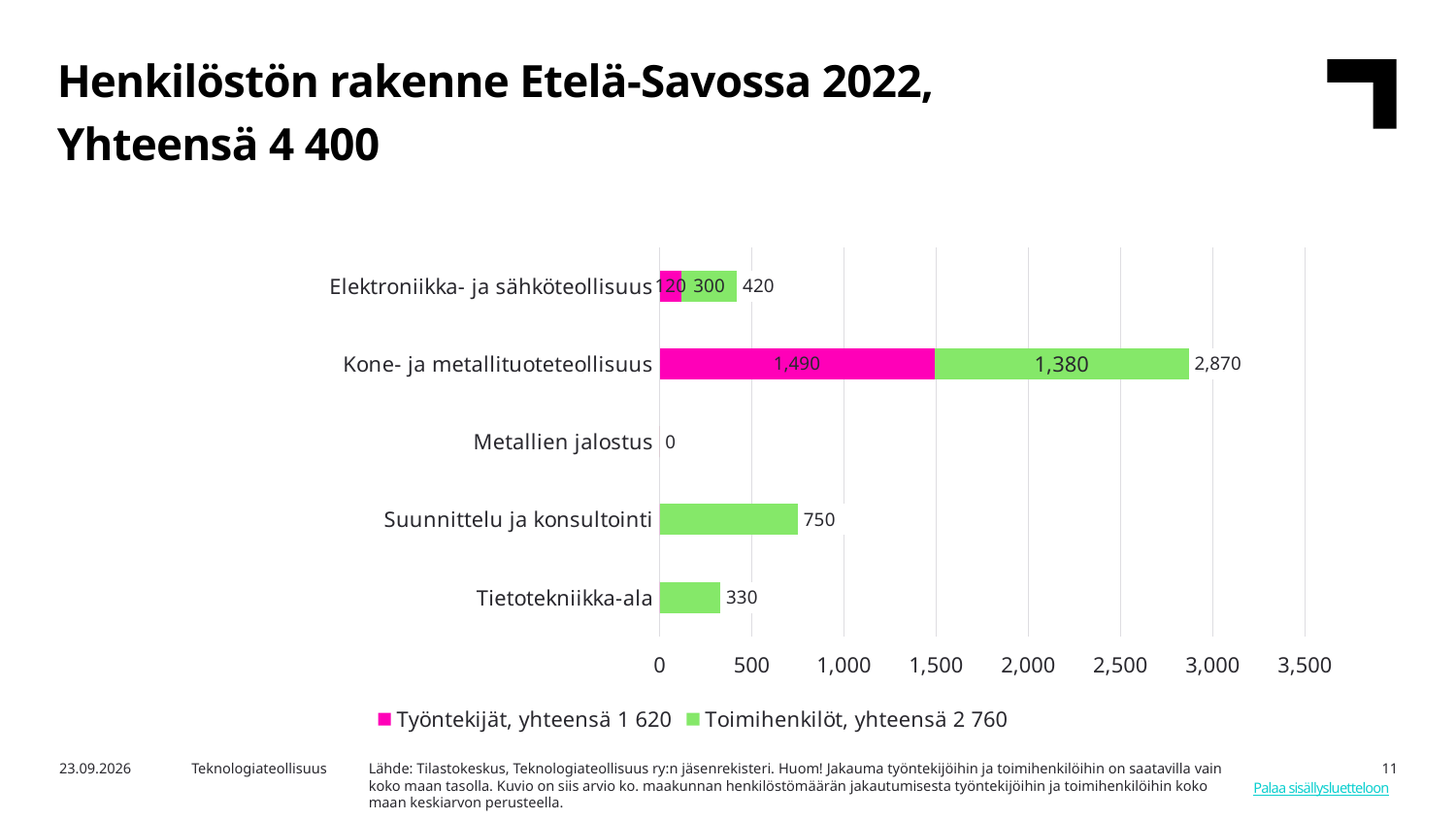
Which category has the highest total value? Kone- ja metallituoteteollisuus What is the difference between the values for Suunnittelu ja konsultointi and Tietotekniikka-ala? 420 What is the value shown for Tietotekniikka-ala? 330 What is the Työntekijät value for Kone- ja metallituoteteollisuus? 1,490 How many series does the legend list? 2 Which category has the lowest value? Metallien jalostus What is the total value shown for Kone- ja metallituoteteollisuus? 2,870 Which is larger: the Työntekijät value or the Toimihenkilöt value for Kone- ja metallituoteteollisuus? Työntekijät How many categories are shown on the chart? 5 What is the value shown for Suunnittelu ja konsultointi? 750 What type of chart is shown on the slide? bar chart What is the Toimihenkilöt value for Kone- ja metallituoteteollisuus? 1,380